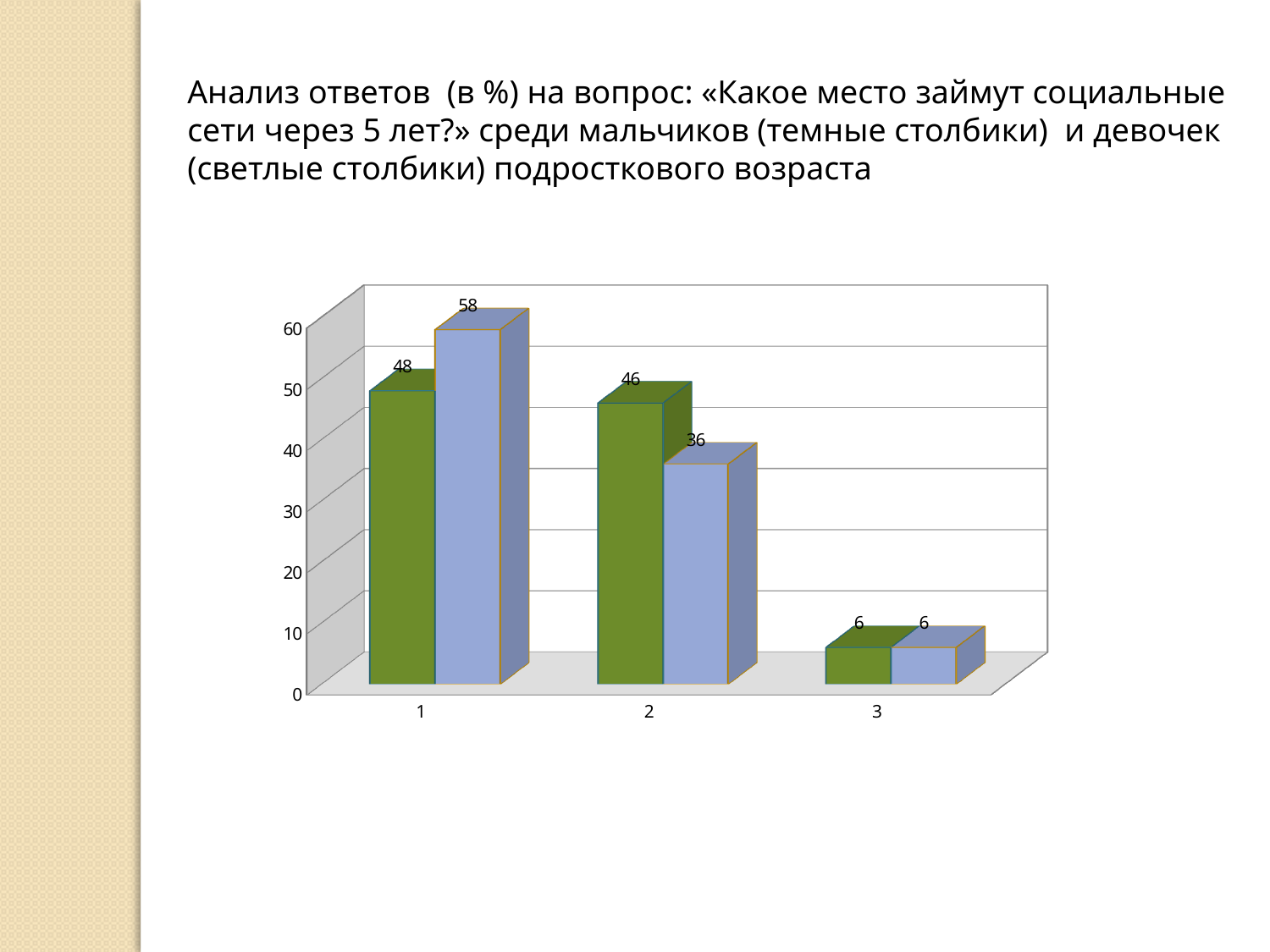
How many categories are shown on the x axis? 3 Which category has the highest light (girls) bar? 1 Do the dark (boys) bars rise or fall from category 1 to category 3? fall What is the value of the dark bar (boys) for category 1? 48 Which category has the lowest dark (boys) bar? 3 What is the value of the light bar (girls) for category 3? 6 For category 2, which bar is larger, the dark (boys) or the light (girls)? dark (boys) What is the value of the light bar (girls) for category 1? 58 What is the value of the dark bar (boys) for category 2? 46 What is the difference between the light (girls) and dark (boys) bars for category 1? 10 What is the value of the light bar (girls) for category 2? 36 What kind of chart is shown on the slide? bar chart